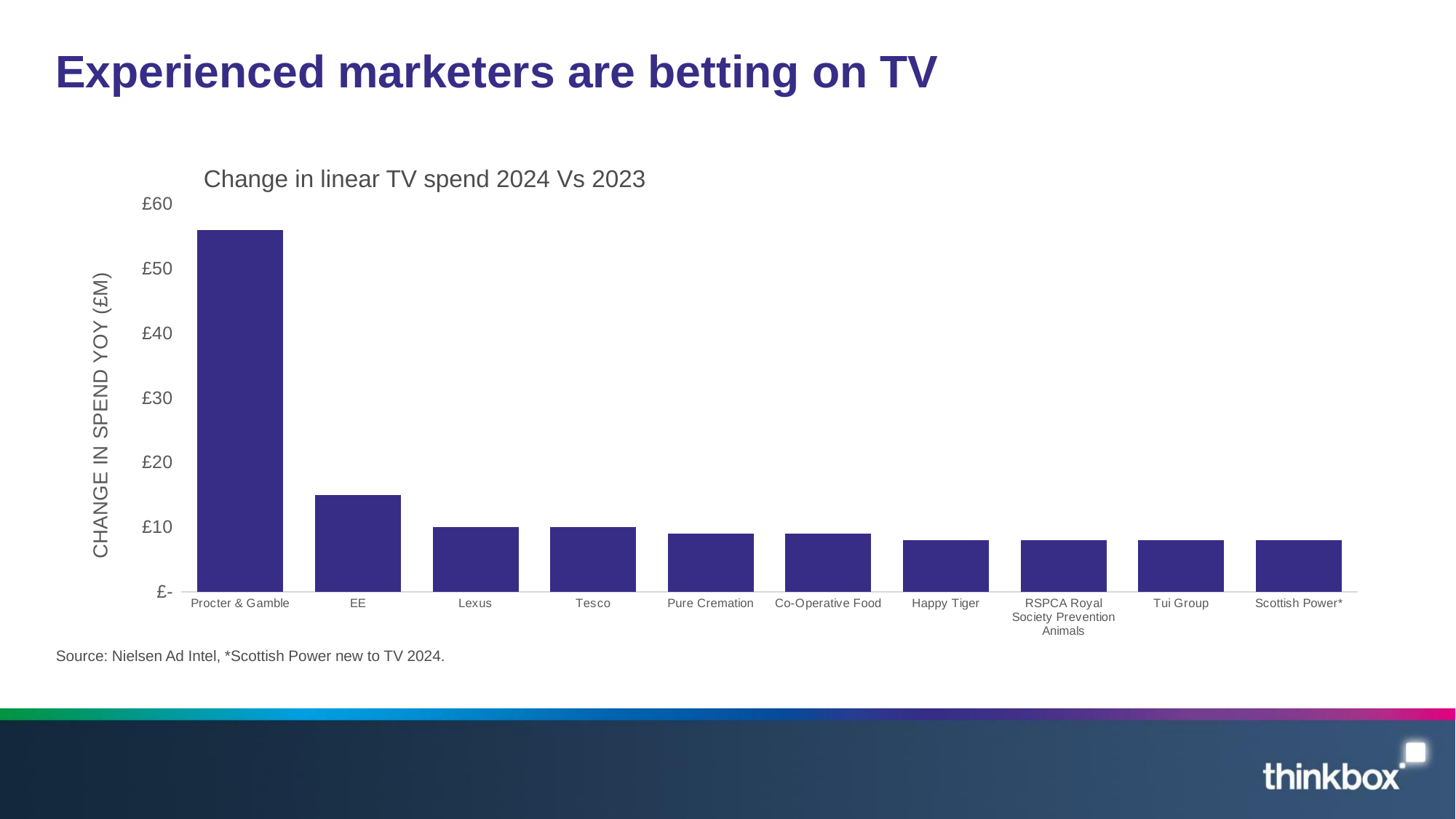
What is the label on the vertical axis of the chart? CHANGE IN SPEND YOY (£M) How many advertisers (categories) are shown in the chart? 10 Is the value for EE greater or less than £10? greater Is the value for Pure Cremation greater or less than £10? less Do the values generally rise or fall moving from left to right across the chart? fall What is the title of the chart? Change in linear TV spend 2024 Vs 2023 Which advertiser has the largest change in linear TV spend? Procter & Gamble Which has a larger change in spend, EE or Lexus? EE What type of chart is shown on the slide? Bar chart Is the value for Tui Group greater or less than £10? less